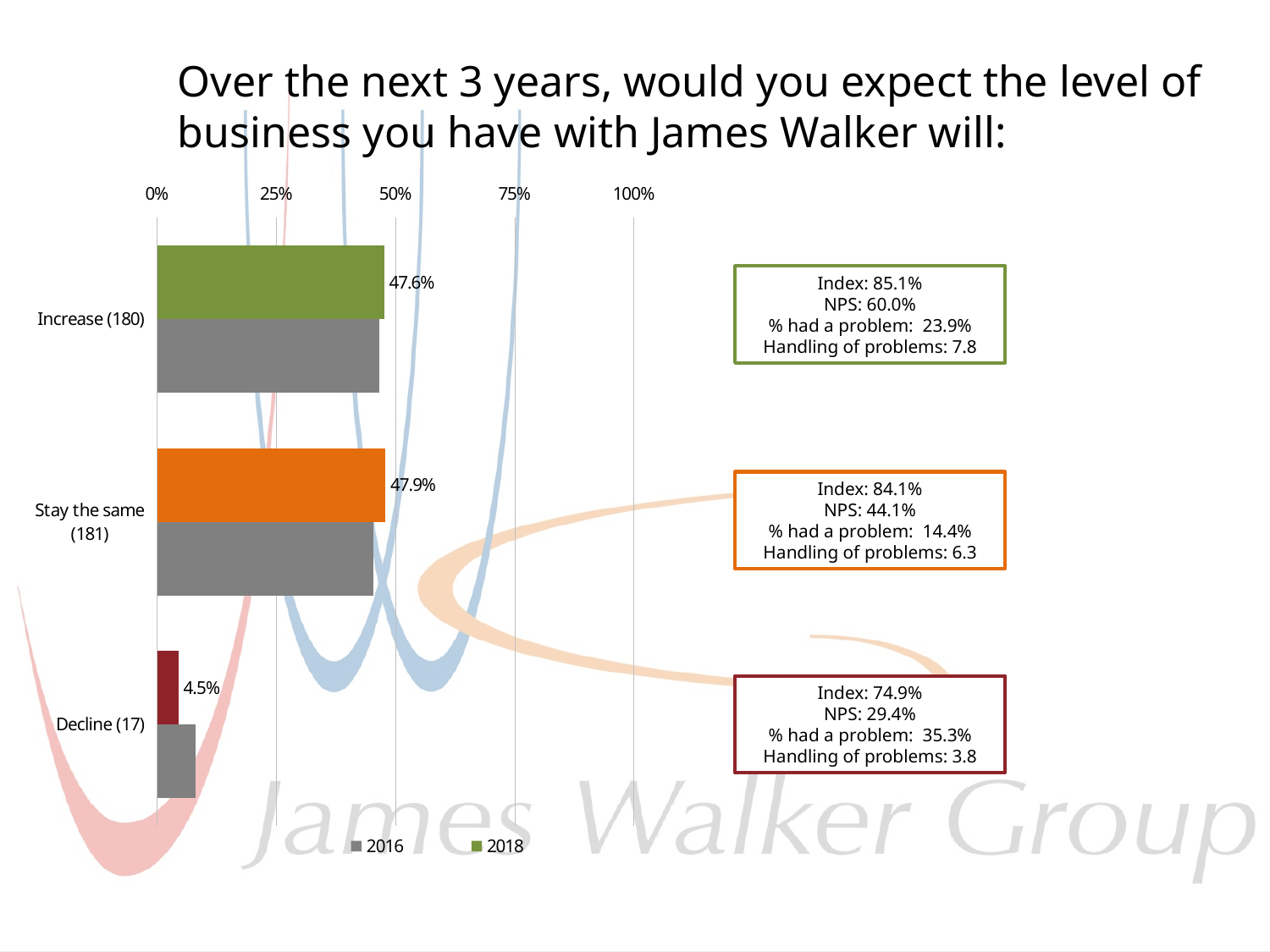
Which category has the lowest 2018 value? Decline (17) What is the 2018 value for Stay the same (181)? 47.9% For 2018, which is larger: Increase (180) or Stay the same (181)? Stay the same (181) What kind of chart is shown on the slide? Bar chart What is the 2018 value for Decline (17)? 4.5% Is the 2016 value for Stay the same (181) greater or less than 50%? less What is the 2018 value for Increase (180)? 47.6% How many categories are shown on the chart? 3 Is the 2016 value for Increase (180) greater or less than 25%? greater How many series does the legend list? 2 What is the difference between the 2018 values for Increase (180) and Decline (17)? 43.1 percentage points Is the 2016 value for Decline (17) greater or less than 25%? less